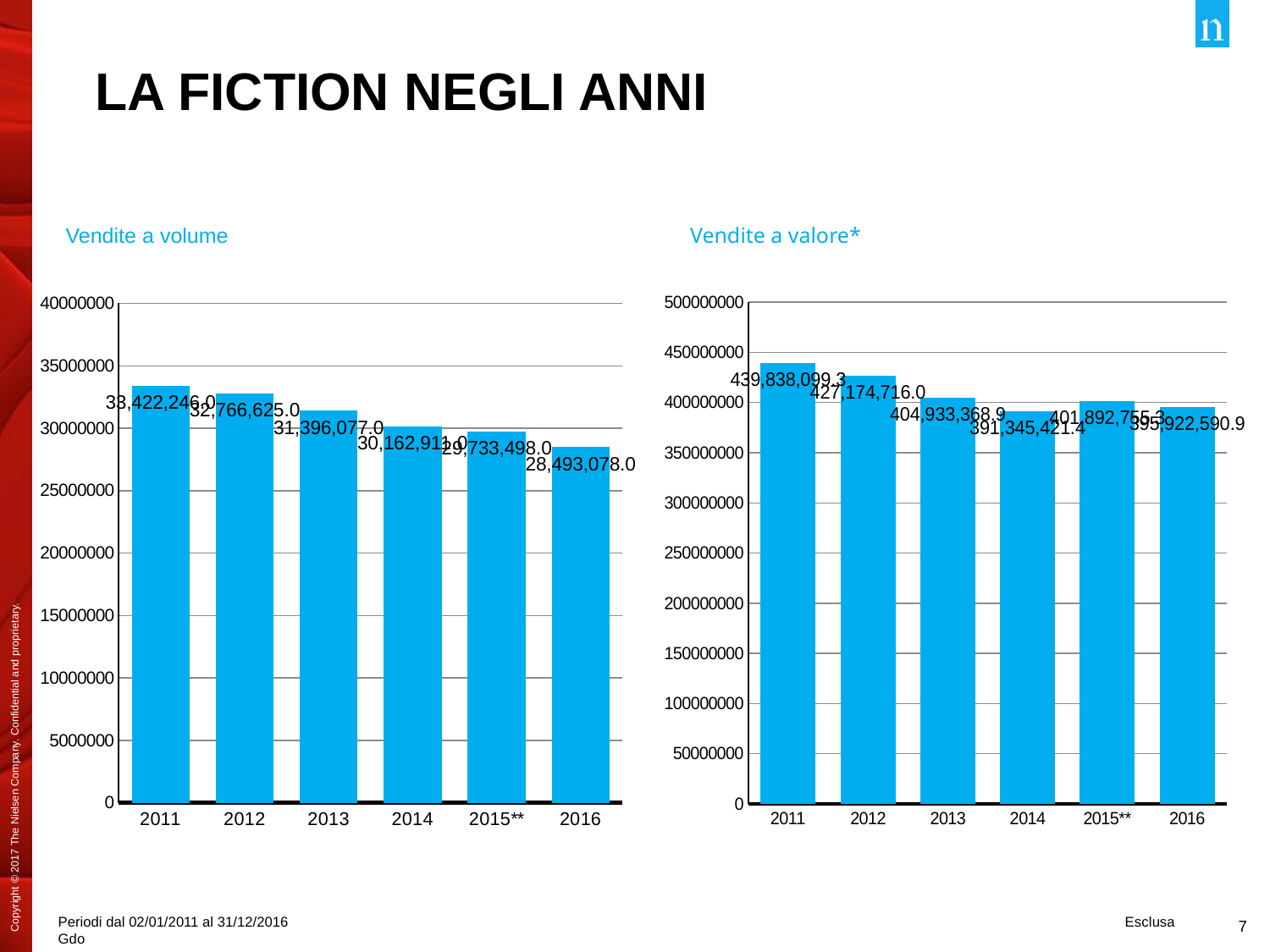
What kind of chart is the 'Vendite a volume' chart on the left? bar chart In the 'Vendite a volume' chart, which year has the highest value? 2011 In the 'Vendite a volume' chart, what is the value for 2011? 33,422,246.0 In the 'Vendite a volume' chart, what is the value for 2016? 28,493,078.0 In the 'Vendite a valore*' chart, which year has the highest value? 2011 How many years are shown on the x axis of the 'Vendite a volume' chart? 6 In the 'Vendite a volume' chart, do the values rise or fall from 2011 to 2016? fall In the 'Vendite a valore*' chart, what is the value for 2011? 439,838,099.3 In the 'Vendite a valore*' chart, what is the difference between the 2011 and 2012 values? 12,663,383.3 In the 'Vendite a volume' chart, is the value for 2013 greater or less than 30000000? greater In the 'Vendite a volume' chart, what is the difference between the 2011 and 2016 values? 4,929,168.0 In the 'Vendite a volume' chart, which year has the lowest value? 2016